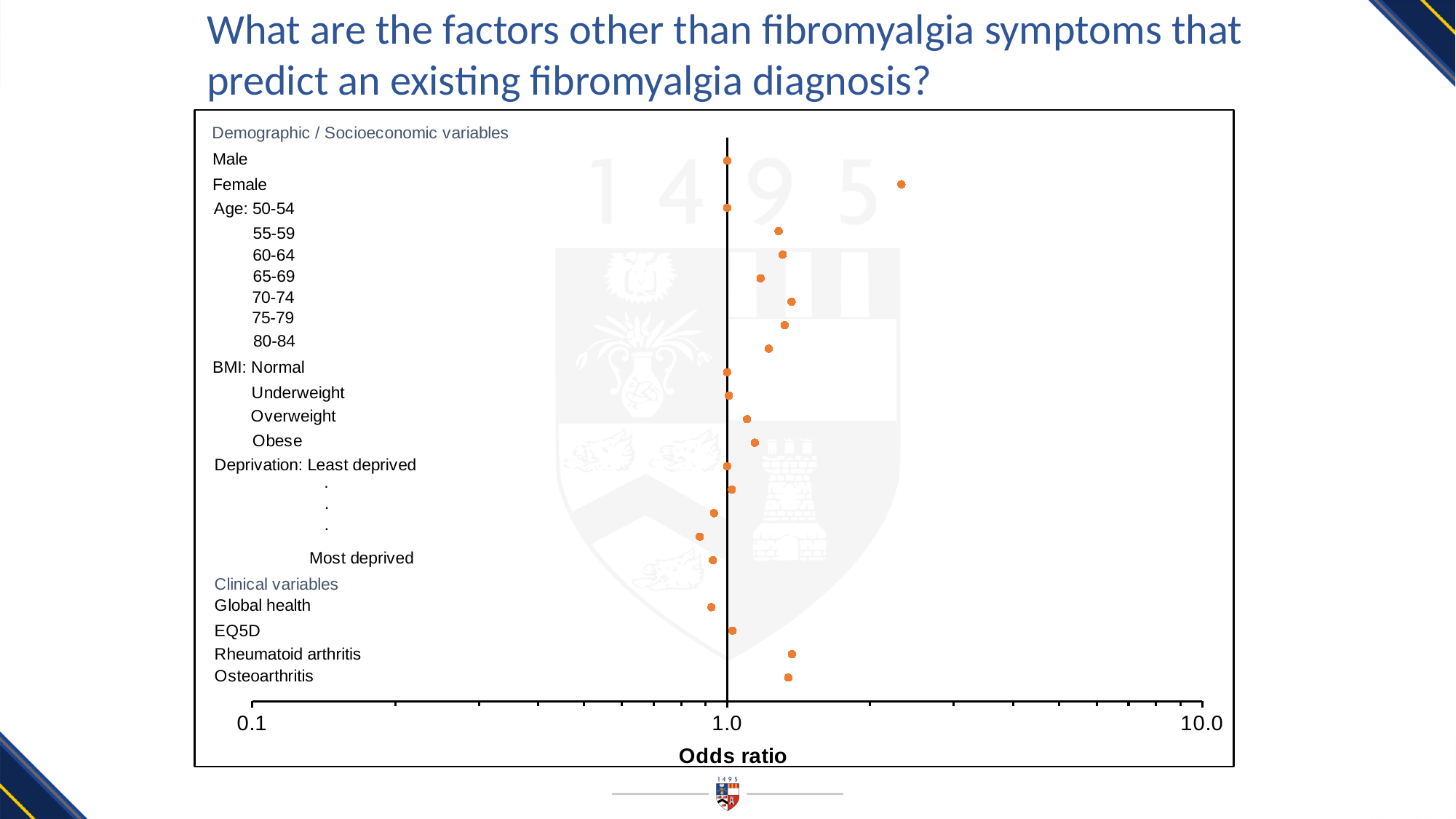
What is the label of the horizontal axis? Odds ratio Which has the larger odds ratio, Rheumatoid arthritis or Global health? Rheumatoid arthritis What kind of chart is shown on the slide? Scatter (dot) plot Is the odds ratio for Most deprived greater or less than 1.0? less Is the odds ratio for Rheumatoid arthritis greater or less than 1.0? greater What are the minimum and maximum values shown on the odds ratio axis? 0.1 and 10.0 Which category has the highest odds ratio? Female Which has the larger odds ratio, Female or Osteoarthritis? Female Is the odds ratio for Global health greater or less than 1.0? less How many data points are plotted on the chart? 22